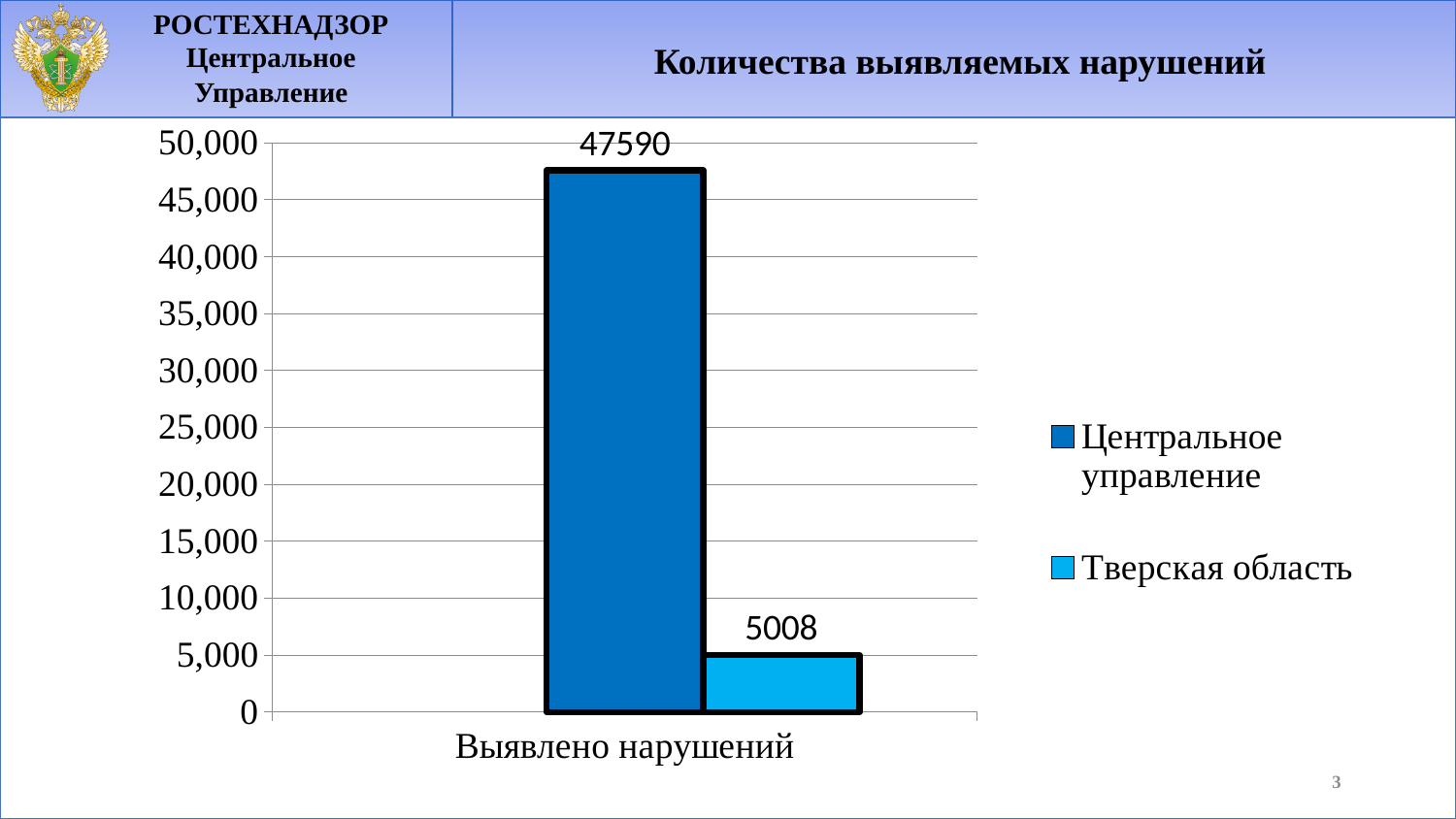
What is the title of the chart on the slide? Количества выявляемых нарушений What is the category label shown on the x axis of the chart? Выявлено нарушений What is the value for Тверская область in the chart? 5008 Is the value for Тверская область greater or less than 10,000? less What is the difference between the values for Центральное управление and Тверская область? 42582 How many series does the legend list? 2 What is the value for Центральное управление in the chart? 47590 What is the maximum value shown on the y axis of the chart? 50,000 What kind of chart is shown on the slide? Bar chart Which series has the lowest value in the chart? Тверская область Is the value for Центральное управление greater or less than 45,000? greater Which series has the higher value, Центральное управление or Тверская область? Центральное управление